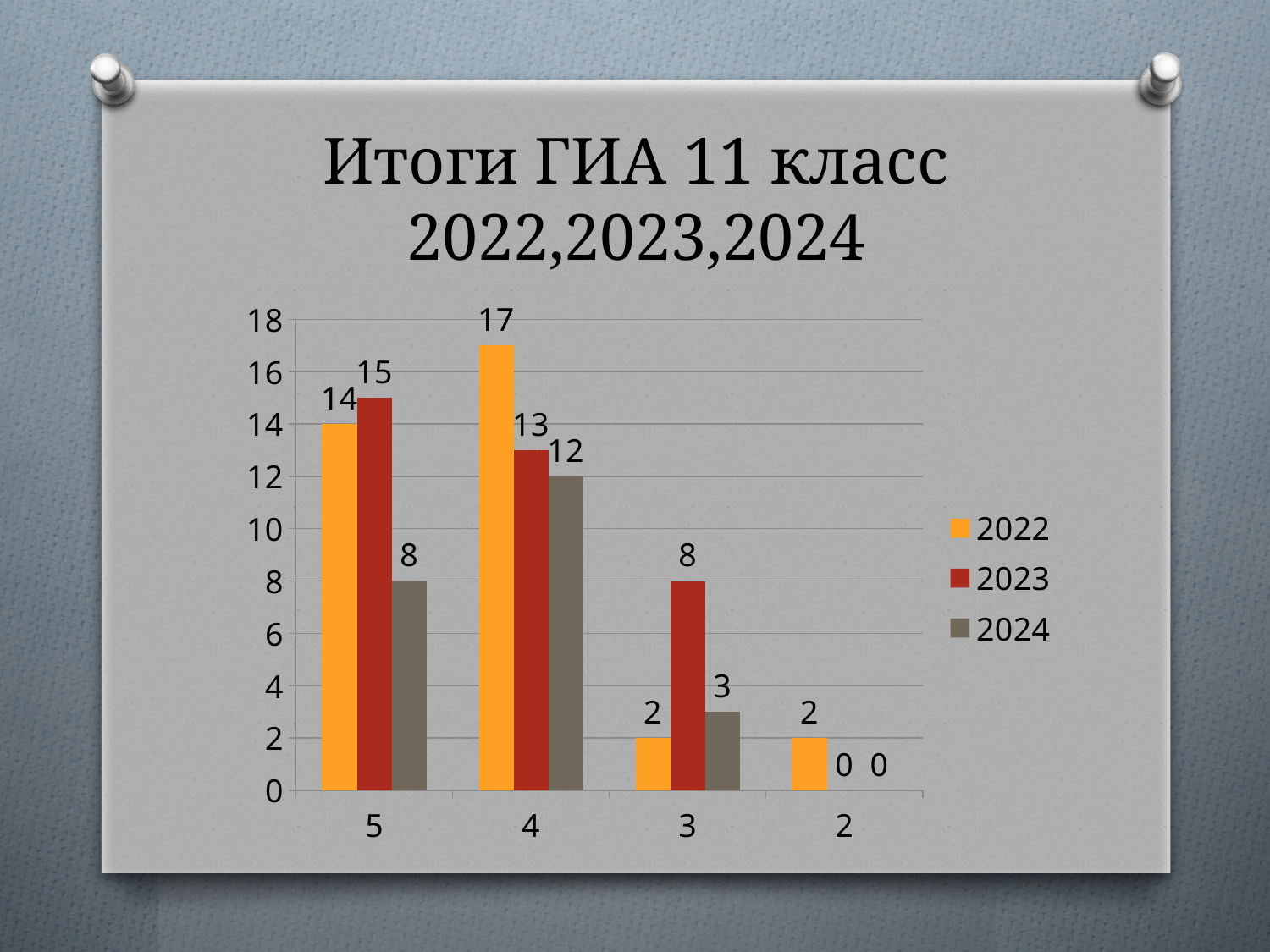
What is the value for category 2 in the 2023 series? 0 What is the title of the chart on the slide? Итоги ГИА 11 класс 2022,2023,2024 Which category has the lowest value in the 2024 series? 2 How many series does the legend list? 3 Which category has the highest value in the 2022 series? 4 How many categories are shown on the x axis? 4 What kind of chart is shown on the slide? bar chart What is the value for category 3 in the 2024 series? 3 What is the value for category 5 in the 2023 series? 15 For category 3, which series has the larger value, 2023 or 2024? 2023 What is the difference between the 2022 and 2024 values for category 5? 6 What is the value for category 4 in the 2022 series? 17